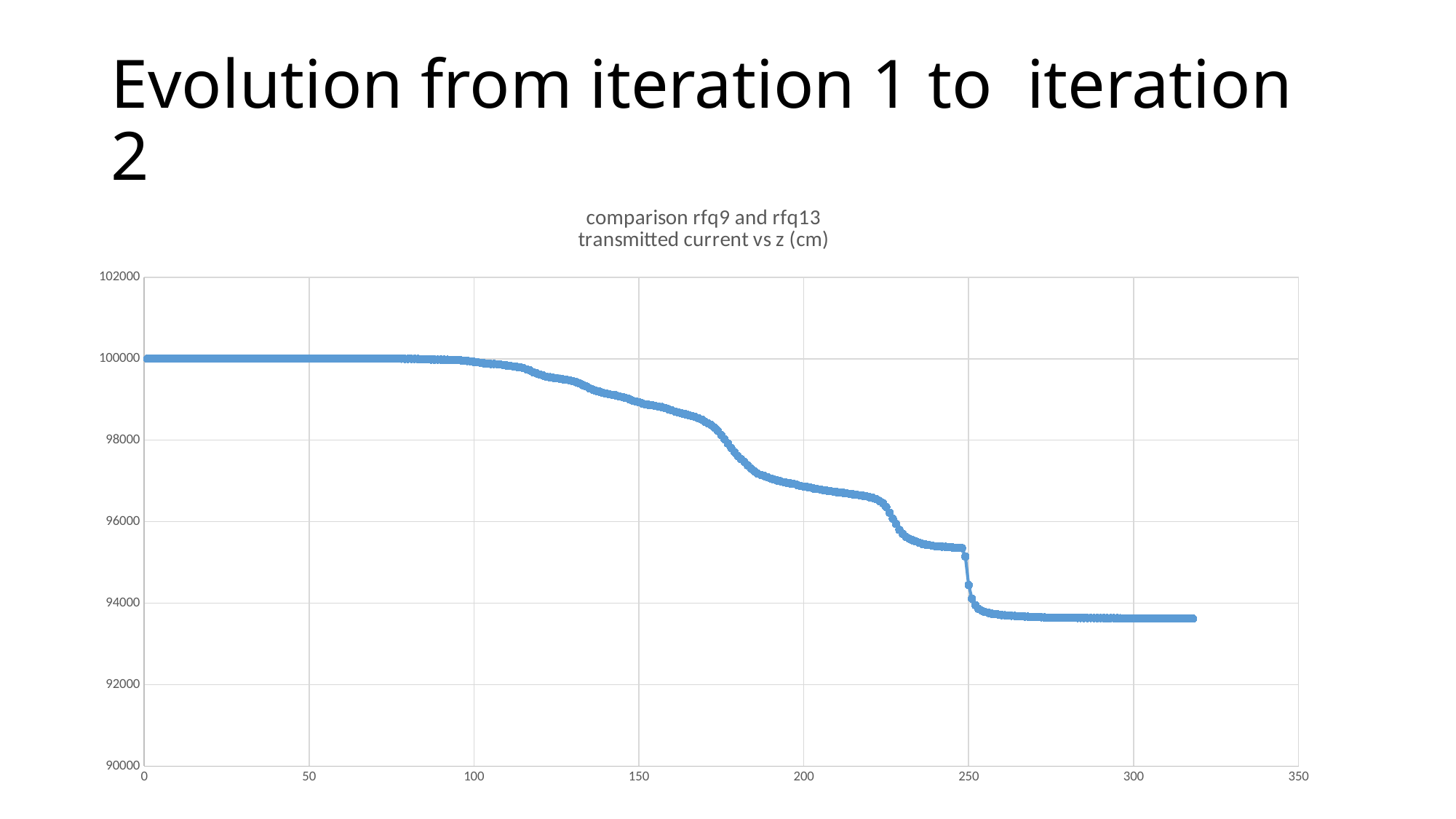
Is the value at z = 300 greater or less than 94000? less Do the plotted values rise or fall as z increases along the x axis? fall What is the highest value shown on the y axis? 102000 Is the value at z = 225 greater or less than 98000? less Is the value at z = 275 greater or less than 92000? greater What kind of chart is shown on the slide? scatter chart What is the title of the chart? comparison rfq9 and rfq13 transmitted current vs z (cm)